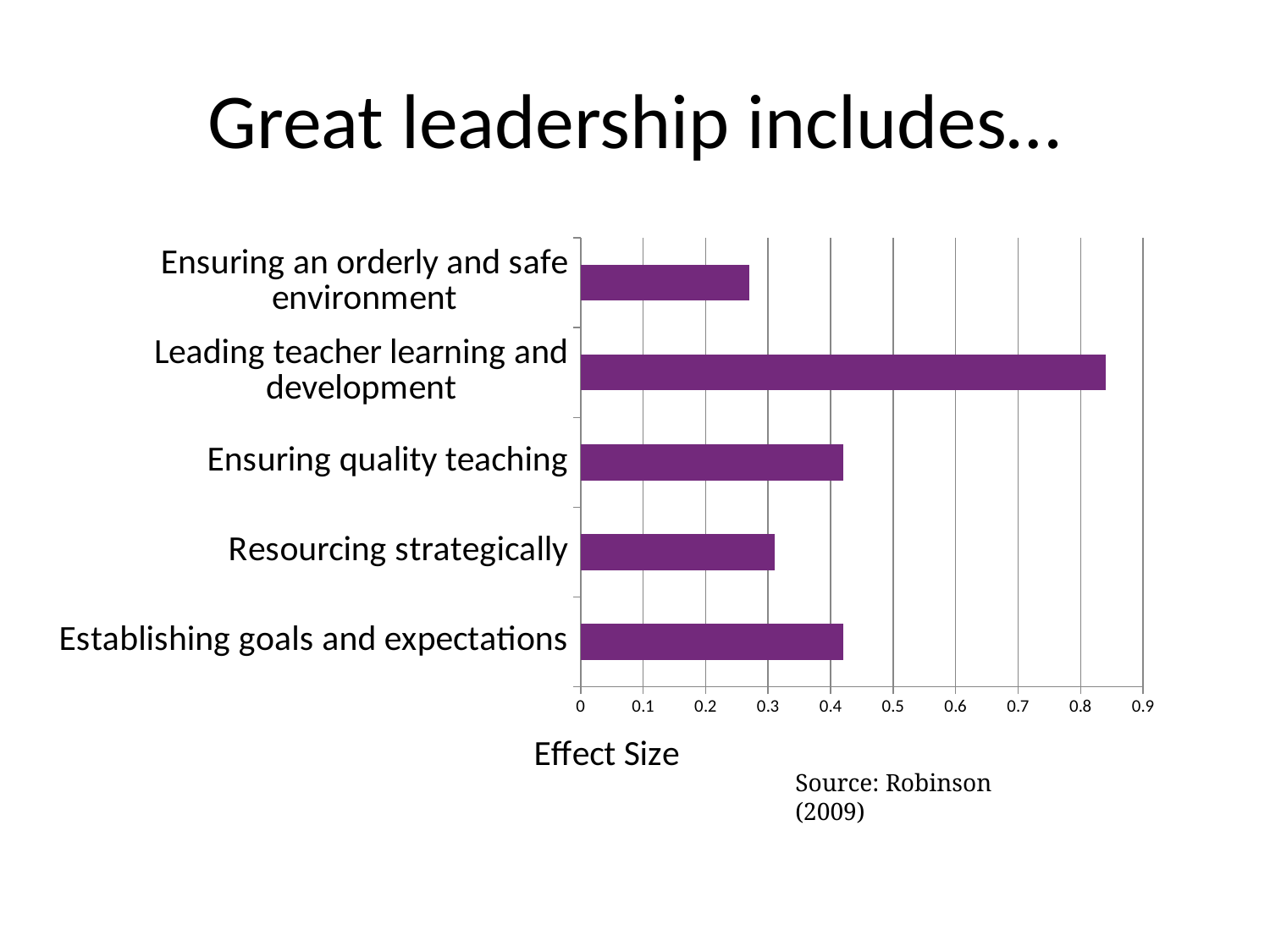
Which category has the highest effect size? Leading teacher learning and development Is the effect size for Leading teacher learning and development greater or less than 0.8? greater Is the effect size for Ensuring quality teaching greater or less than 0.5? less What is the title of the horizontal axis? Effect Size Which has a larger effect size: Leading teacher learning and development or Ensuring quality teaching? Leading teacher learning and development Is the effect size for Ensuring an orderly and safe environment greater or less than 0.3? less What source is cited for the chart data? Robinson (2009) Which category has the lowest effect size? Ensuring an orderly and safe environment What kind of chart is shown on the slide? bar chart How many categories are plotted in the chart? 5